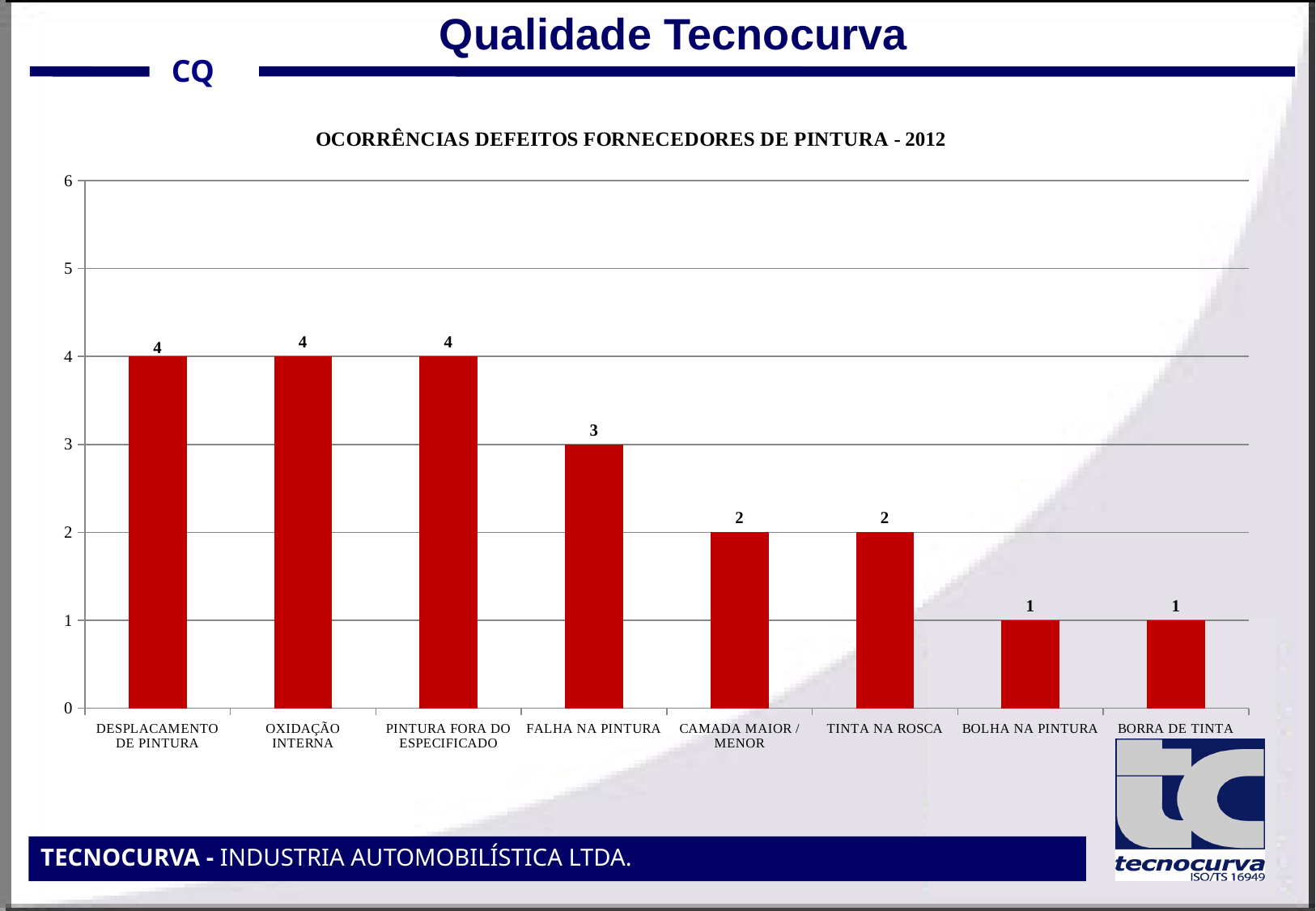
How many categories are shown on the x axis? 8 What is the difference between the values for FALHA NA PINTURA and CAMADA MAIOR / MENOR? 1 Which is larger, the value for PINTURA FORA DO ESPECIFICADO or the value for TINTA NA ROSCA? PINTURA FORA DO ESPECIFICADO What is the title of the chart? OCORRÊNCIAS DEFEITOS FORNECEDORES DE PINTURA - 2012 What is the value for OXIDAÇÃO INTERNA? 4 What is the value for TINTA NA ROSCA? 2 What is the difference between the values for DESPLACAMENTO DE PINTURA and BOLHA NA PINTURA? 3 What is the value for BORRA DE TINTA? 1 What is the value for FALHA NA PINTURA? 3 Is the value for FALHA NA PINTURA greater or less than 5? less Do the values rise or fall from left to right along the x axis? fall What kind of chart is shown on the slide? bar chart